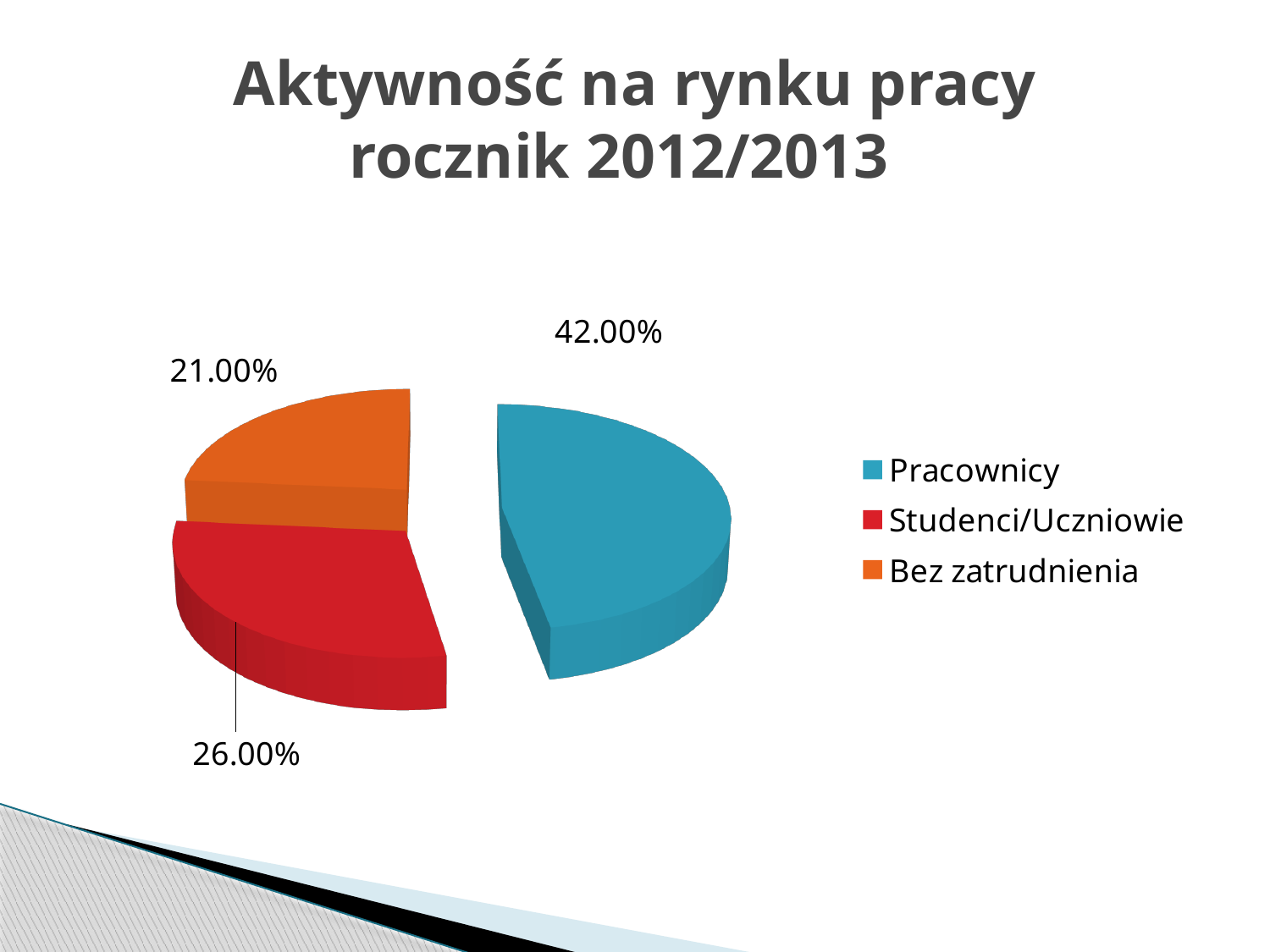
What percentage is shown for Bez zatrudnienia? 21.00% Which category has the smallest slice of the pie? Bez zatrudnienia What is the title of the chart on the slide? Aktywność na rynku pracy rocznik 2012/2013 What percentage is shown for Studenci/Uczniowie? 26.00% Which colour represents Bez zatrudnienia in the legend? Orange Which category has the largest slice of the pie? Pracownicy How many categories does the pie chart show? 3 What percentage is shown for Pracownicy? 42.00% Which is larger, the slice for Studenci/Uczniowie or the slice for Bez zatrudnienia? Studenci/Uczniowie What is the difference in percentage points between Pracownicy and Studenci/Uczniowie? 16.00% What kind of chart is shown on the slide? Pie chart What is the difference in percentage points between Studenci/Uczniowie and Bez zatrudnienia? 5.00%